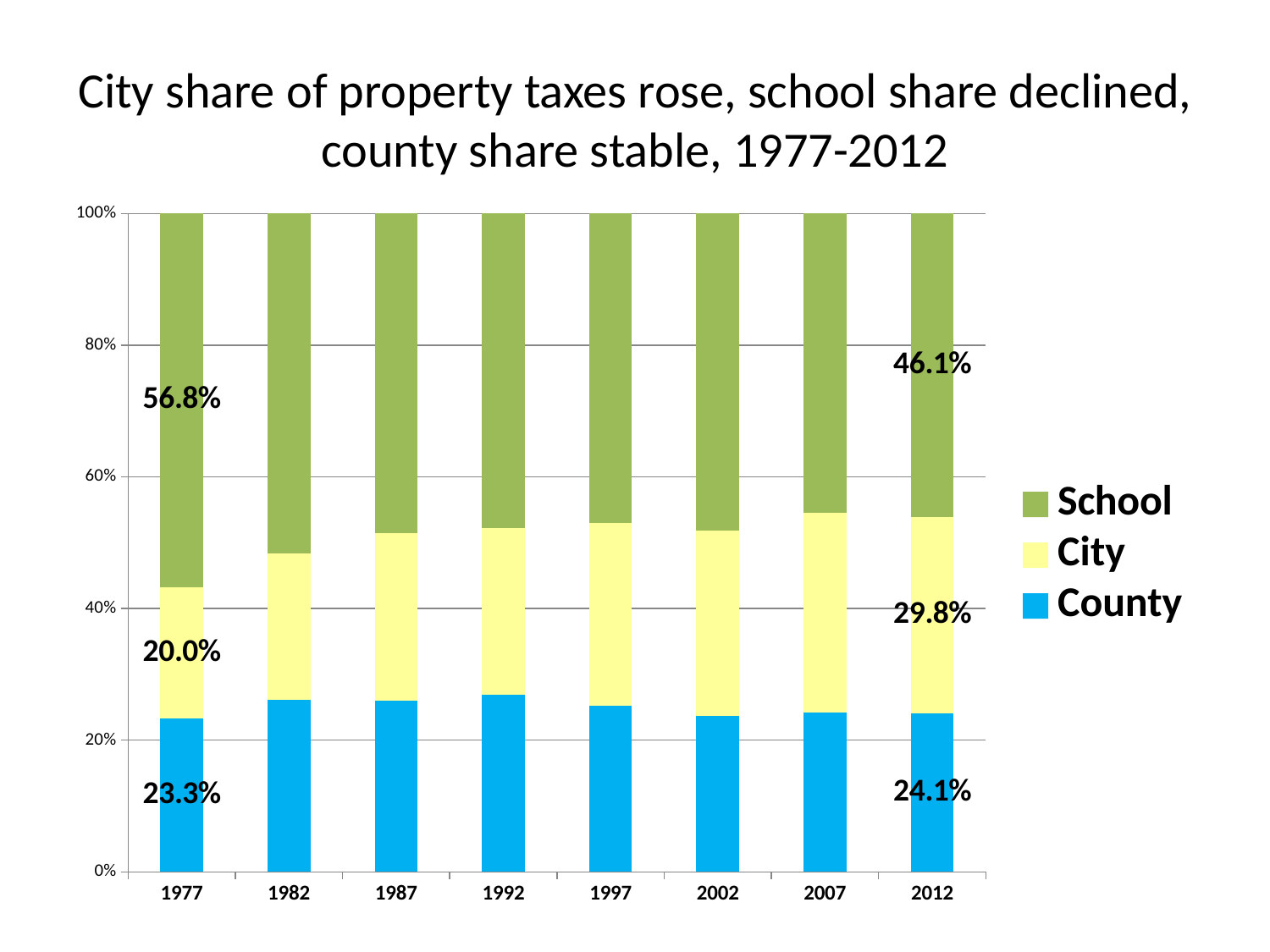
What was the County share of property taxes in 1977? 23.3% How many series does the legend list? 3 What was the School share of property taxes in 2012? 46.1% Is the County share in 1992 greater or less than 20%? greater By how many percentage points did the School share fall between 1977 and 2012? 10.7 percentage points What was the School share of property taxes in 1977? 56.8% How many years are shown on the x axis? 8 By how many percentage points did the City share rise between 1977 and 2012? 9.8 percentage points What was the City share of property taxes in 2012? 29.8% Which series had the smallest share in 2012? County Which series had the largest share in 1977? School Was the City share larger in 1977 or in 2012? 2012